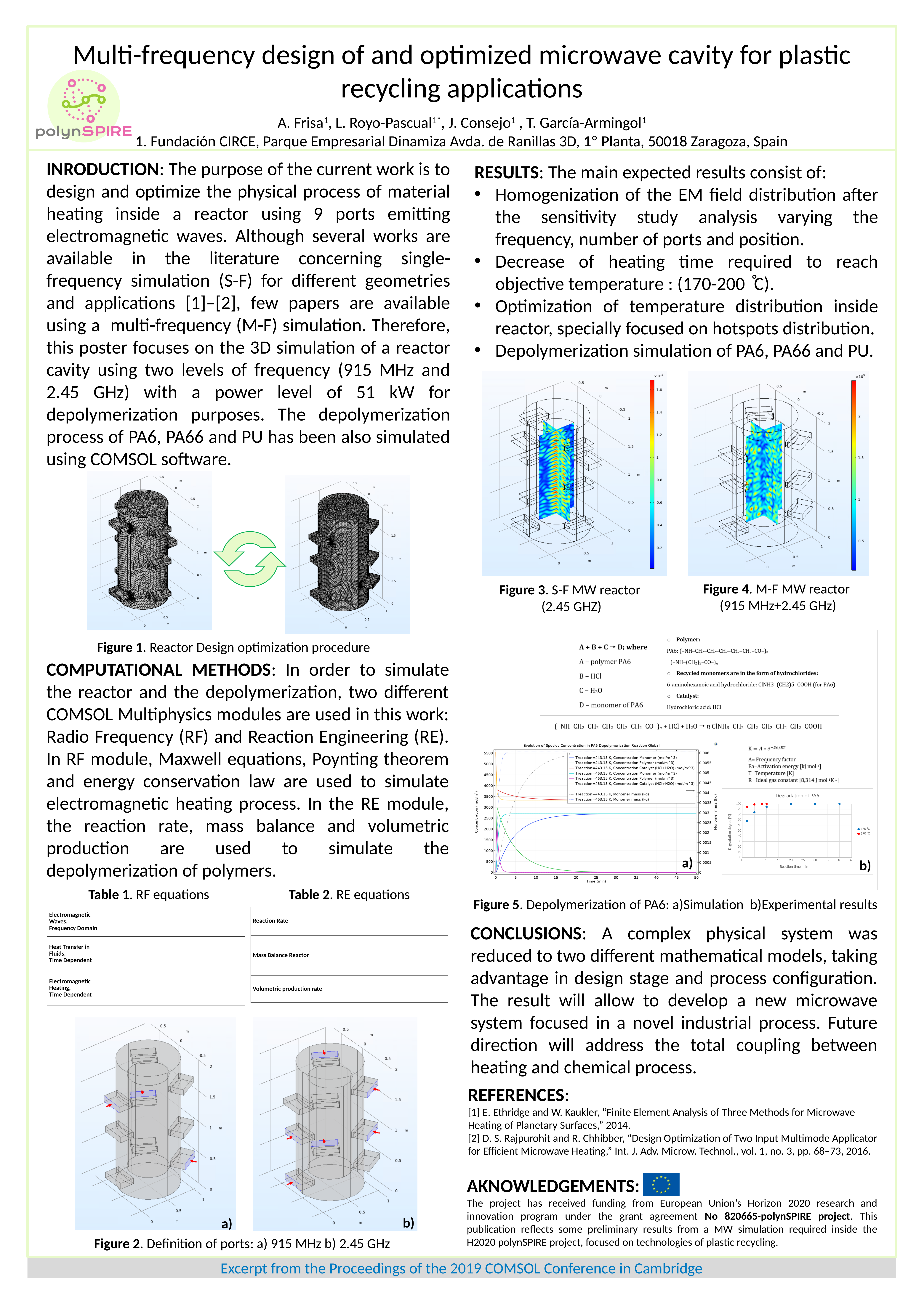
In the 'Degradation of PA6' chart (Figure 5b), is the degradation degree for 170 °C at 40 min greater or less than 50? greater What kind of chart is Figure 5b, 'Degradation of PA6'? scatter chart In the 'Evolution of Species Concentration in PA6 Depolymerization Reaction Global' chart (Figure 5a), does the monomer mass curve rise or fall over time? rise How many series does the legend of the 'Degradation of PA6' chart (Figure 5b) list? 2 What kind of chart is Figure 5a, 'Evolution of Species Concentration in PA6 Depolymerization Reaction Global'? line chart In the 'Degradation of PA6' chart (Figure 5b), is the degradation degree for 190 °C at 10 min greater or less than 80? greater In the 'Evolution of Species Concentration in PA6 Depolymerization Reaction Global' chart (Figure 5a), what is the highest tick shown on the left y axis? 5500 In the 'Degradation of PA6' chart (Figure 5b), does the degradation degree for 170 °C rise or fall as reaction time increases? rise What is the x-axis label of the 'Evolution of Species Concentration in PA6 Depolymerization Reaction Global' chart (Figure 5a)? Time (min) How many entries does the legend of the 'Evolution of Species Concentration in PA6 Depolymerization Reaction Global' chart (Figure 5a) list? 8 In the 'Degradation of PA6' chart (Figure 5b), which two temperatures are listed in the legend? 170 °C and 190 °C